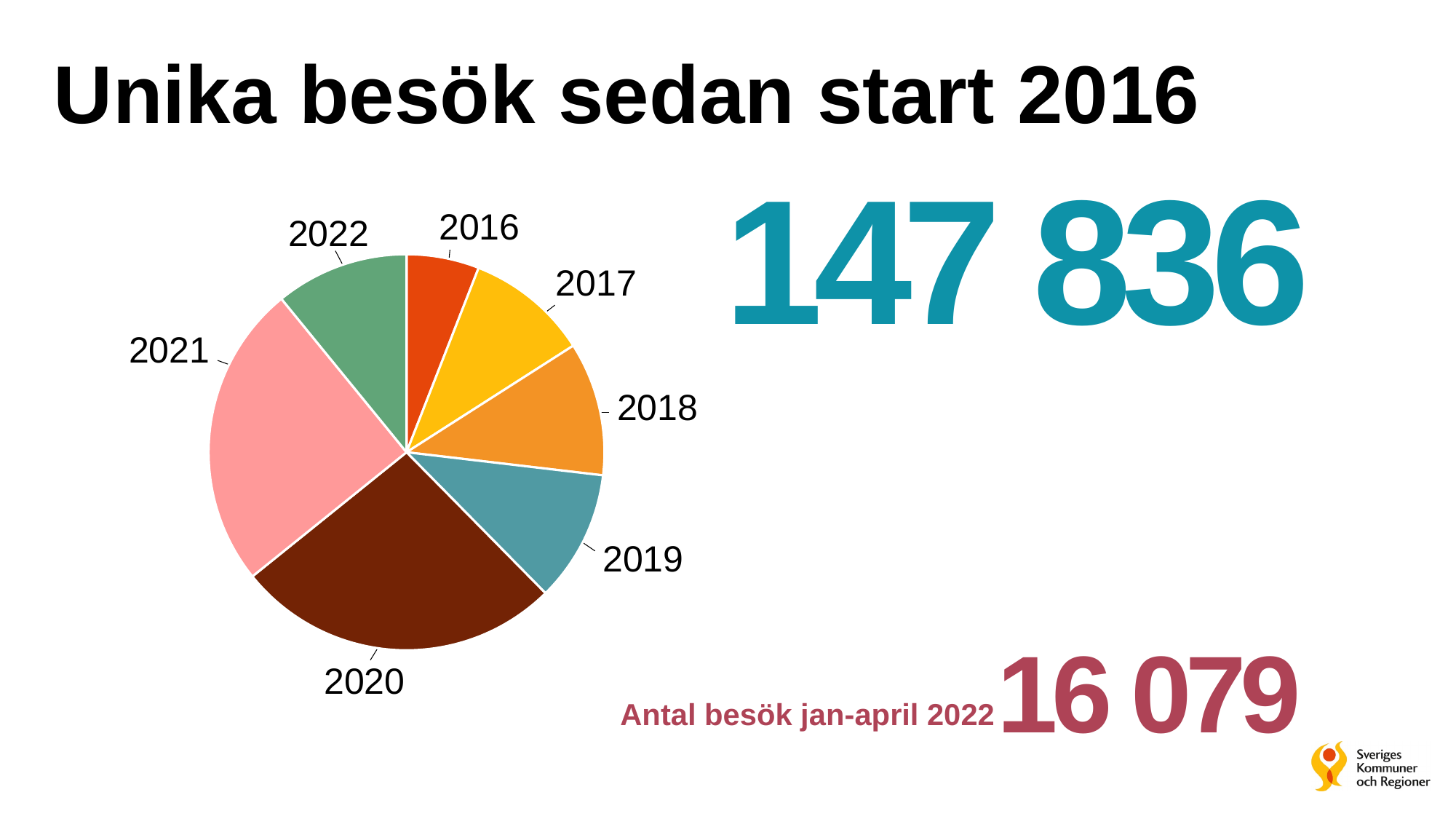
Which slice is larger, 2016 or 2020? 2020 Which year has the smallest slice in the pie chart? 2016 What kind of chart is shown on the slide? Pie chart What colour is the 2020 slice of the pie chart? Dark brown How many slices does the pie chart have? 7 Which slice is larger, 2016 or 2018? 2018 Which slice is larger, 2020 or 2018? 2020 Which year has the largest slice in the pie chart? 2020 What is the title of the slide containing the pie chart? Unika besök sedan start 2016